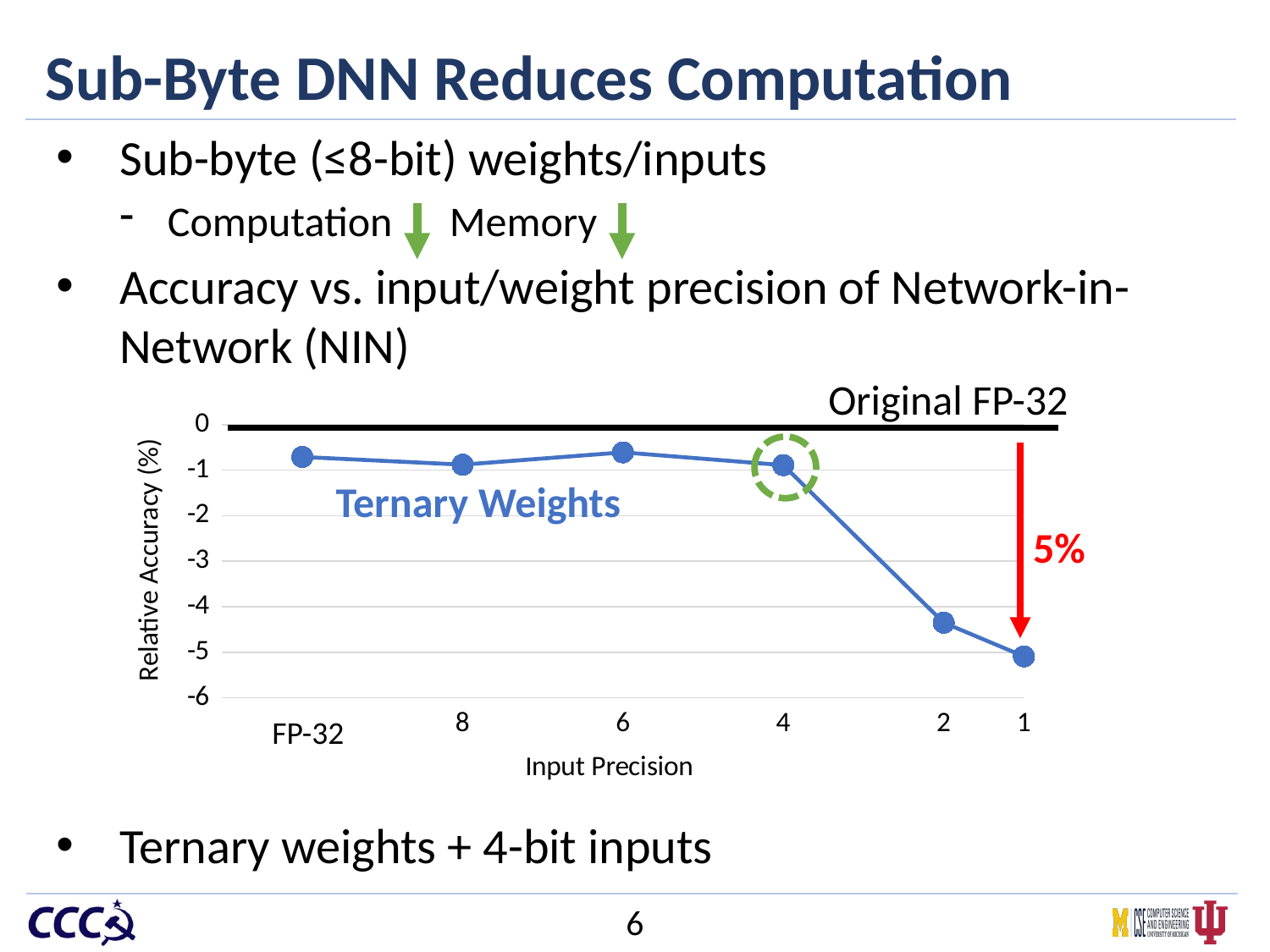
Which input precision has the lowest relative accuracy? 1 Is the relative accuracy for input precision 8 greater or less than -2? greater Is the relative accuracy for input precision 1 greater or less than -4? less How many input precision points are plotted on the chart? 6 What is the label of the y axis of the chart? Relative Accuracy (%) Does the relative accuracy rise or fall as input precision goes from 4 to 1 along the x axis? fall Is the relative accuracy for input precision 6 greater or less than -1? greater Which has the higher relative accuracy, input precision 4 or input precision 2? 4 What kind of chart is shown on the slide? line chart What is the label of the x axis of the chart? Input Precision